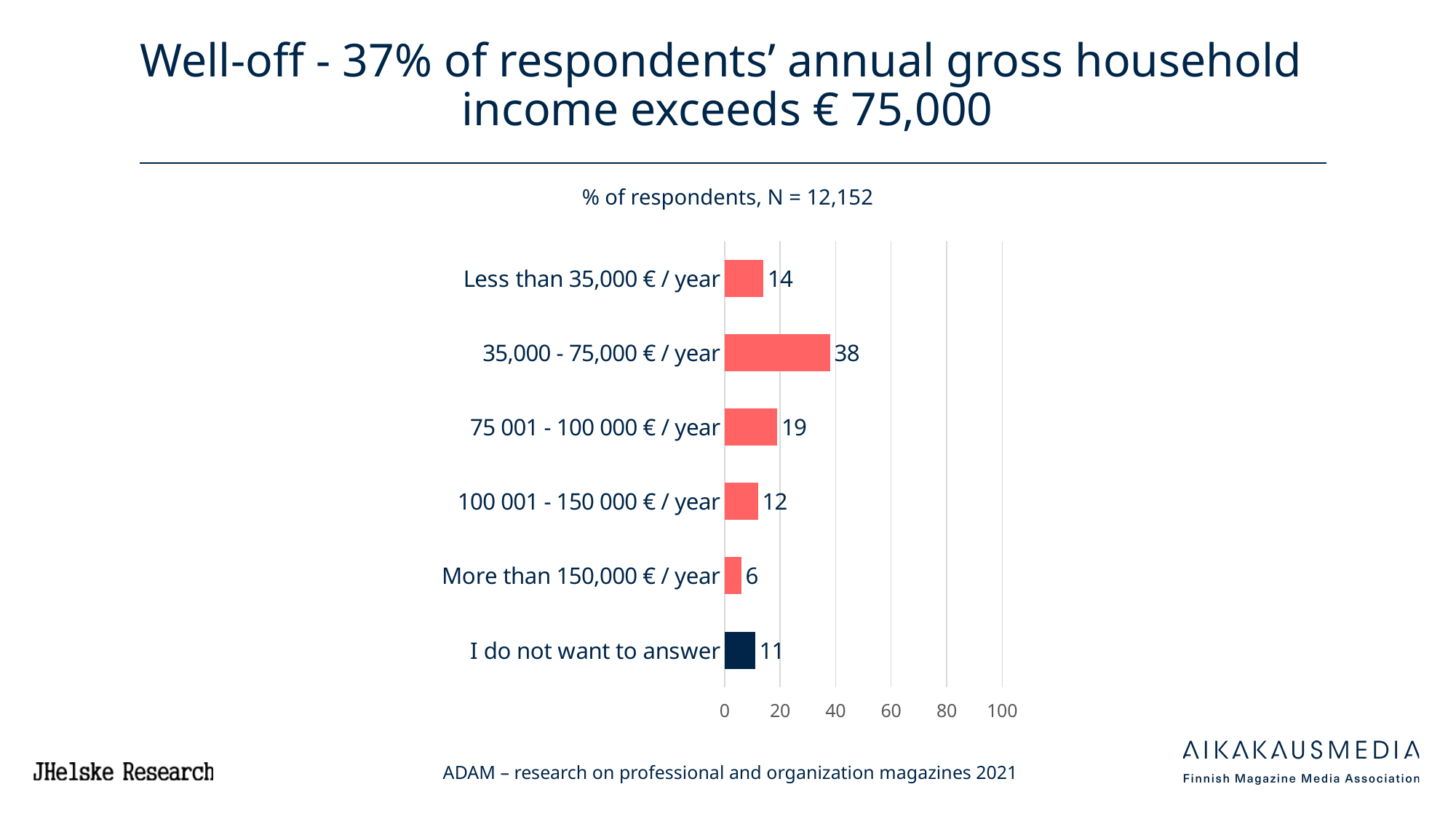
What is the value for "I do not want to answer"? 11 Which category's bar is coloured dark navy rather than red? I do not want to answer What is the value for "35,000 - 75,000 € / year"? 38 Is the value for "35,000 - 75,000 € / year" greater or less than 20? greater Which category has the lowest value? More than 150,000 € / year What is the value for "Less than 35,000 € / year"? 14 Which is larger, the value for "Less than 35,000 € / year" or the value for "100 001 - 150 000 € / year"? Less than 35,000 € / year What is the value for "More than 150,000 € / year"? 6 What kind of chart is shown on the slide? bar chart What is the difference between the values for "35,000 - 75,000 € / year" and "75 001 - 100 000 € / year"? 19 Which category has the highest value? 35,000 - 75,000 € / year How many categories are shown in the chart? 6